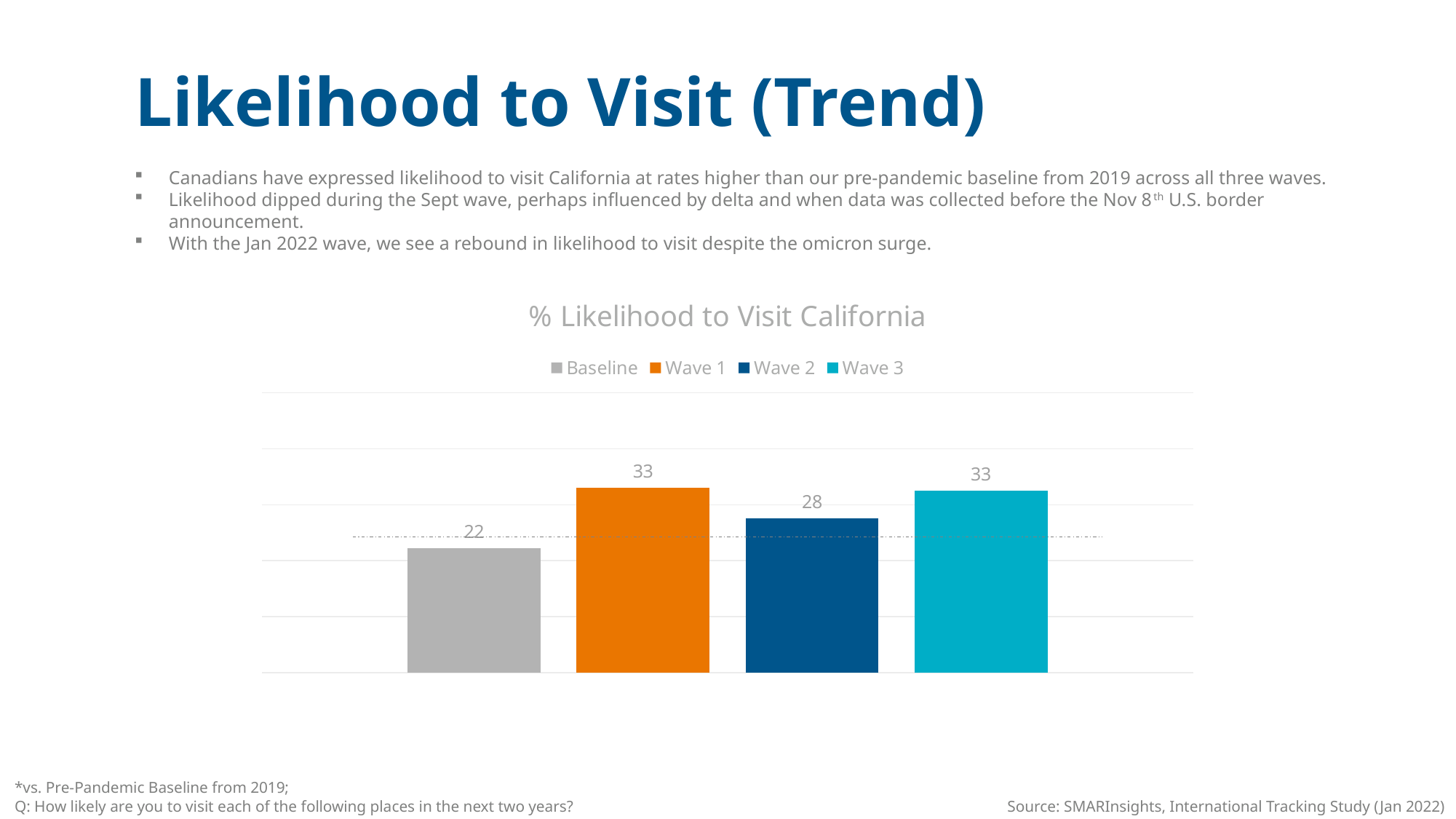
What is the difference between the Wave 3 and Wave 2 values? 5 What is the value for Wave 1? 33 What is the value for Wave 3? 33 What is the value for Wave 2? 28 Which is larger, the value for Wave 2 or the value for Baseline? Wave 2 How many series does the legend list? 4 What is the value for Baseline in the % Likelihood to Visit California chart? 22 What kind of chart is shown on the slide? Bar chart How many bars are plotted in the chart? 4 What is the title of the chart? % Likelihood to Visit California What is the difference between the Wave 1 and Baseline values? 11 Which series has the lowest value? Baseline